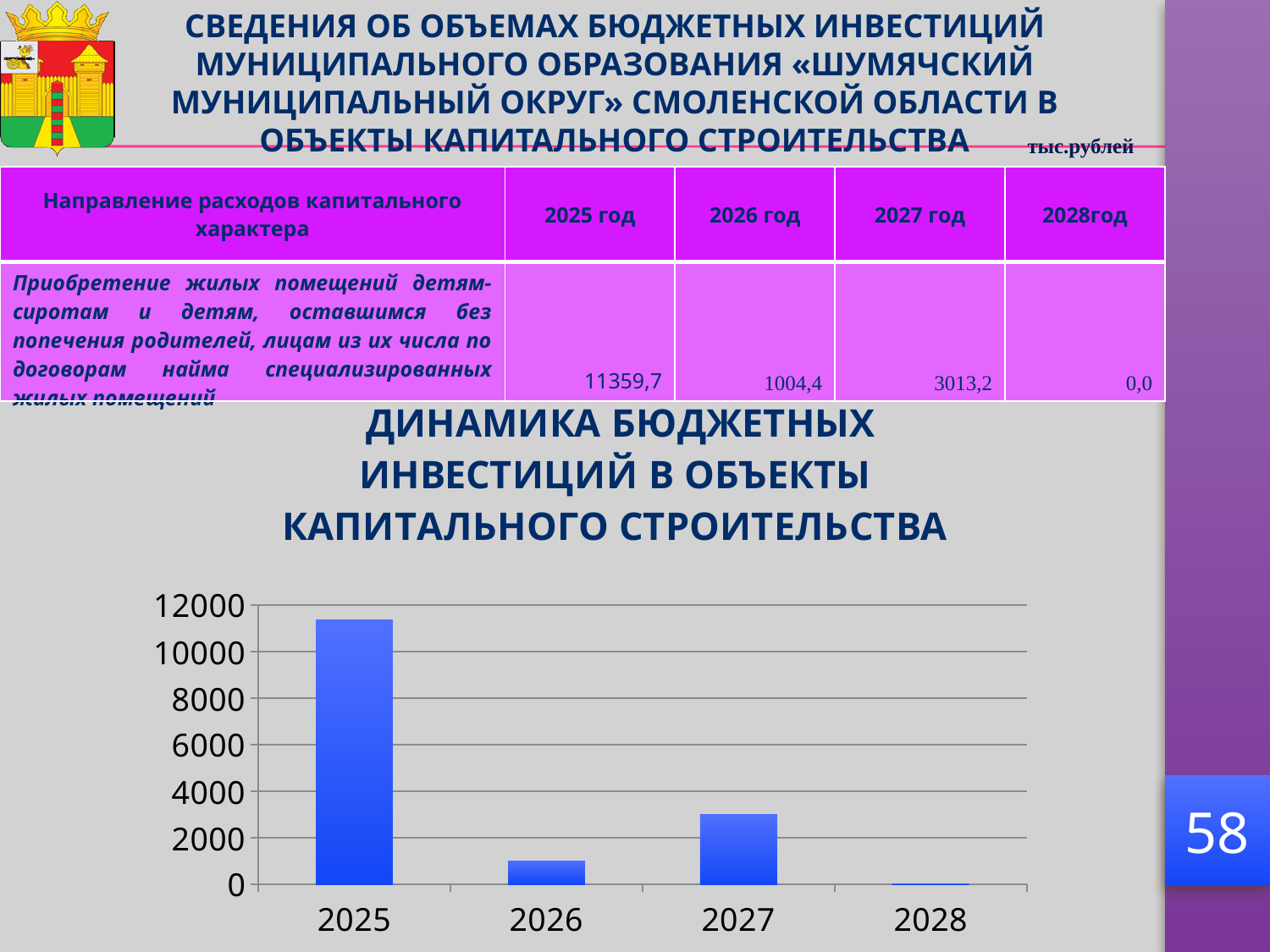
What is the title of the chart? ДИНАМИКА БЮДЖЕТНЫХ ИНВЕСТИЦИЙ В ОБЪЕКТЫ КАПИТАЛЬНОГО СТРОИТЕЛЬСТВА Is the value for 2025 in the chart greater or less than 10000? greater According to the table on the slide, what is the value for 2025 (thousand rubles)? 11359,7 Which is larger in the chart, the value for 2026 or the value for 2027? 2027 Which year has the lowest bar in the chart? 2028 What is the highest tick value shown on the vertical axis of the chart? 12000 Which year has the highest bar in the chart? 2025 According to the table on the slide, what is the value for 2028 (thousand rubles)? 0,0 Is the value for 2026 in the chart greater or less than 2000? less What kind of chart is shown on the slide? bar chart How many years are shown on the x axis of the chart? 4 Is the value for 2027 in the chart greater or less than 2000? greater